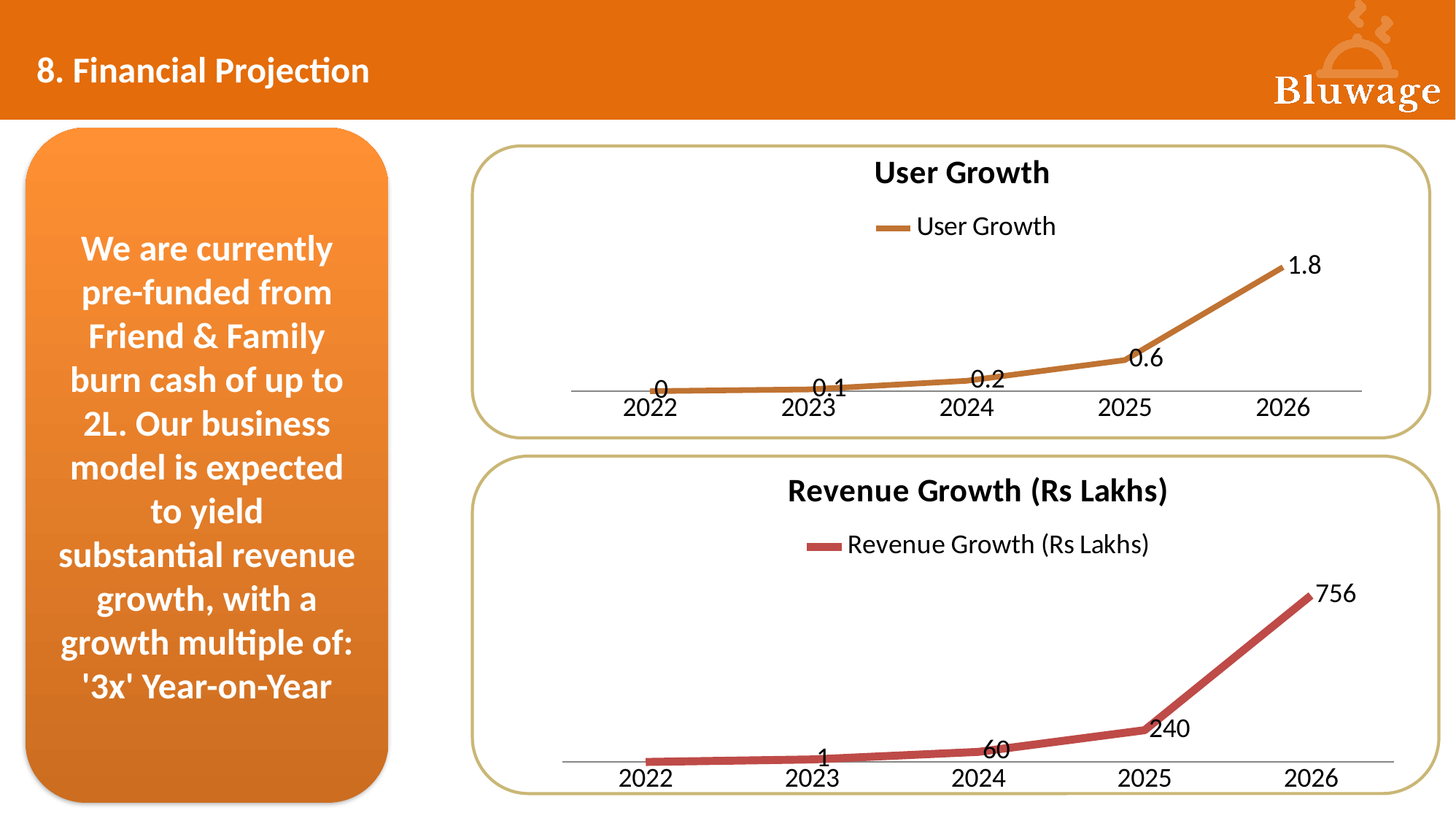
In the Revenue Growth (Rs Lakhs) chart, which is larger, the value for 2024 or the value for 2025? 2025 In the Revenue Growth (Rs Lakhs) chart, what is the value for 2024? 60 What kind of chart is the Revenue Growth (Rs Lakhs) chart? line chart In the Revenue Growth (Rs Lakhs) chart, which year has the highest value? 2026 In the User Growth chart, what is the value for 2026? 1.8 In the User Growth chart, which year has the lowest value? 2022 In the User Growth chart, do the values rise or fall from 2022 to 2026? rise In the User Growth chart, what is the value for 2025? 0.6 In the User Growth chart, what is the difference between the 2026 and 2025 values? 1.2 How many years are plotted in the User Growth chart? 5 In the Revenue Growth (Rs Lakhs) chart, what is the value for 2025? 240 In the Revenue Growth (Rs Lakhs) chart, what is the difference between the 2026 and 2025 values? 516